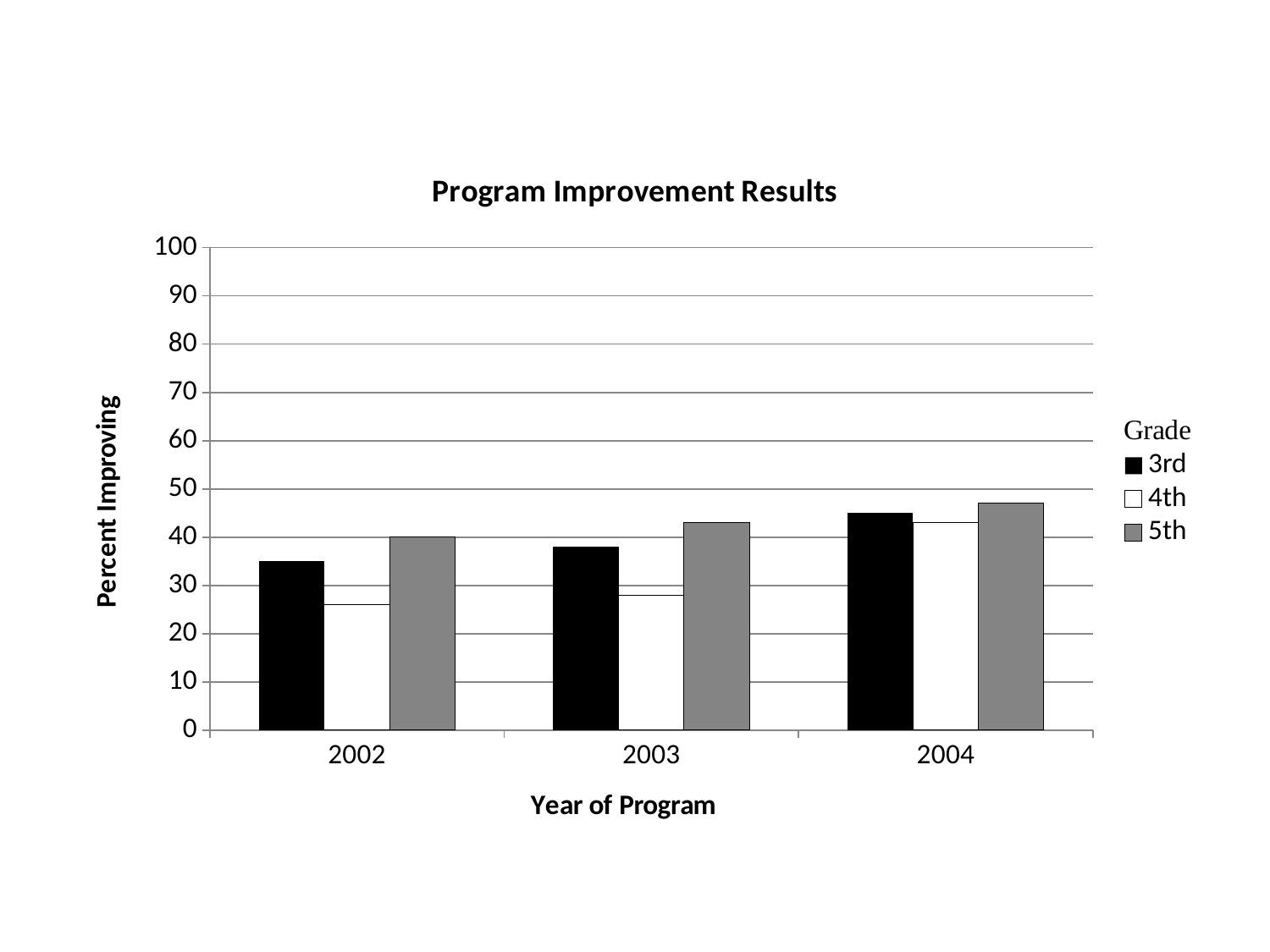
What is the title of the chart? Program Improvement Results How many series does the legend list? 3 Does the percent improving for 4th grade rise or fall from 2002 to 2004? rise Which grade has the lowest percent improving in 2003? 4th Which grade has the highest percent improving in 2002? 5th Is the value for 4th grade in 2002 greater or less than 30? less What kind of chart is shown on the slide? bar chart How many years are shown on the x axis? 3 Is the value for 3rd grade in 2004 greater or less than 40? greater Which is larger, the 3rd grade value in 2002 or the 3rd grade value in 2004? 2004 What is the label of the y axis? Percent Improving Is the value for 5th grade in 2003 greater or less than 50? less